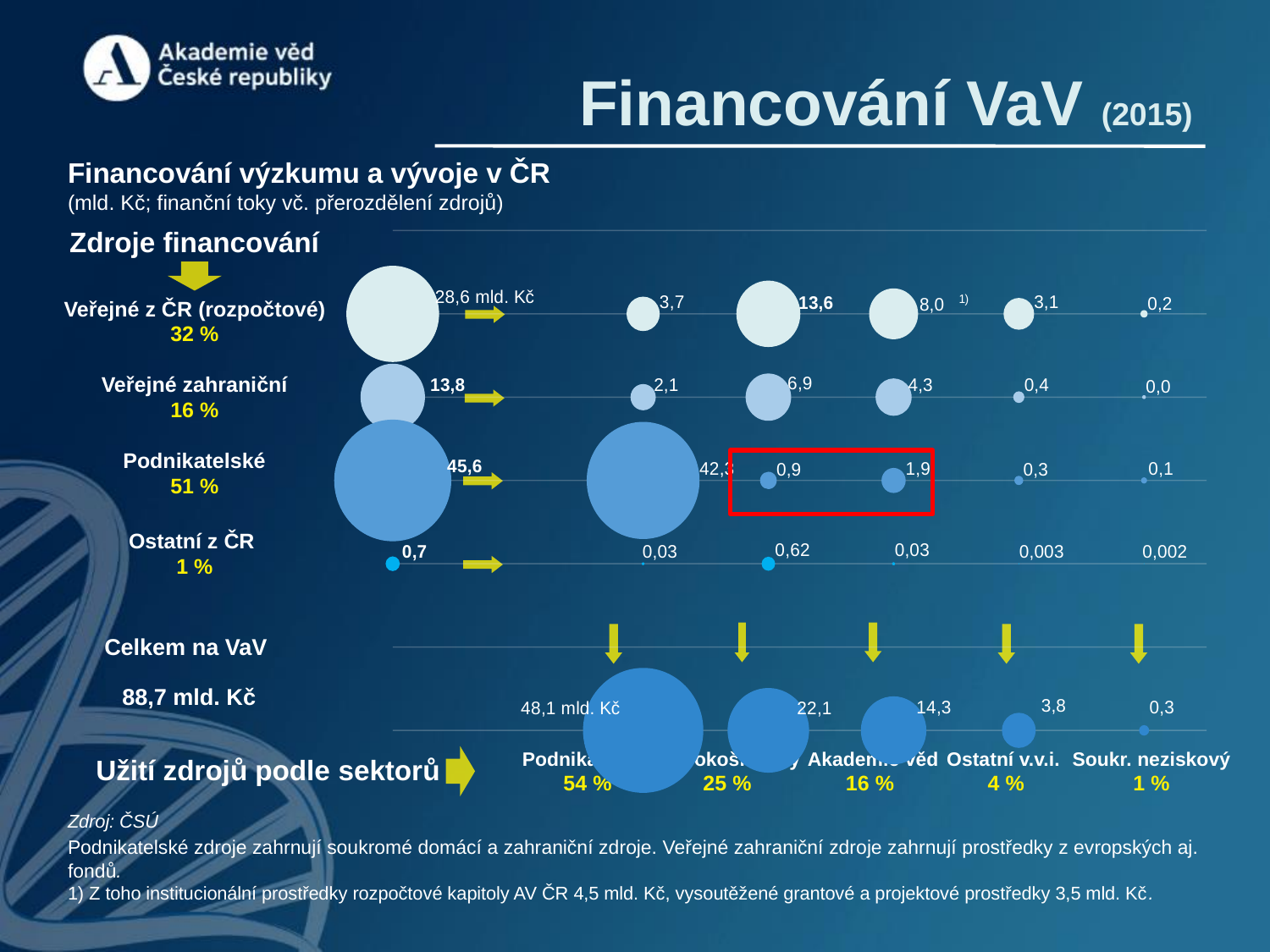
What is the difference between the Veřejné z ČR (rozpočtové) funding to Akademie věd and the Veřejné zahraniční funding to Akademie věd? 3,7 What is the total value of Podnikatelské sources of financing? 45,6 Which is larger: Podnikatelské funding to Akademie věd or Podnikatelské funding to Ostatní v.v.i.? Akademie věd What share of funding use goes to Ostatní v.v.i.? 4 % Which sector of use has the smallest total funding? Soukr. neziskový How much funding from Veřejné z ČR (rozpočtové) sources goes to Akademie věd? 8,0 What is the total amount of funding used by Akademie věd? 14,3 How many sources of financing (rows) are shown in the chart? 4 What share of financing sources is Veřejné zahraniční? 16 % Which source of financing has the largest share? Podnikatelské How much funding from Veřejné zahraniční sources goes to Ostatní v.v.i.? 0,4 What is the total amount of R&D funding (Celkem na VaV) shown on the slide? 88,7 mld. Kč